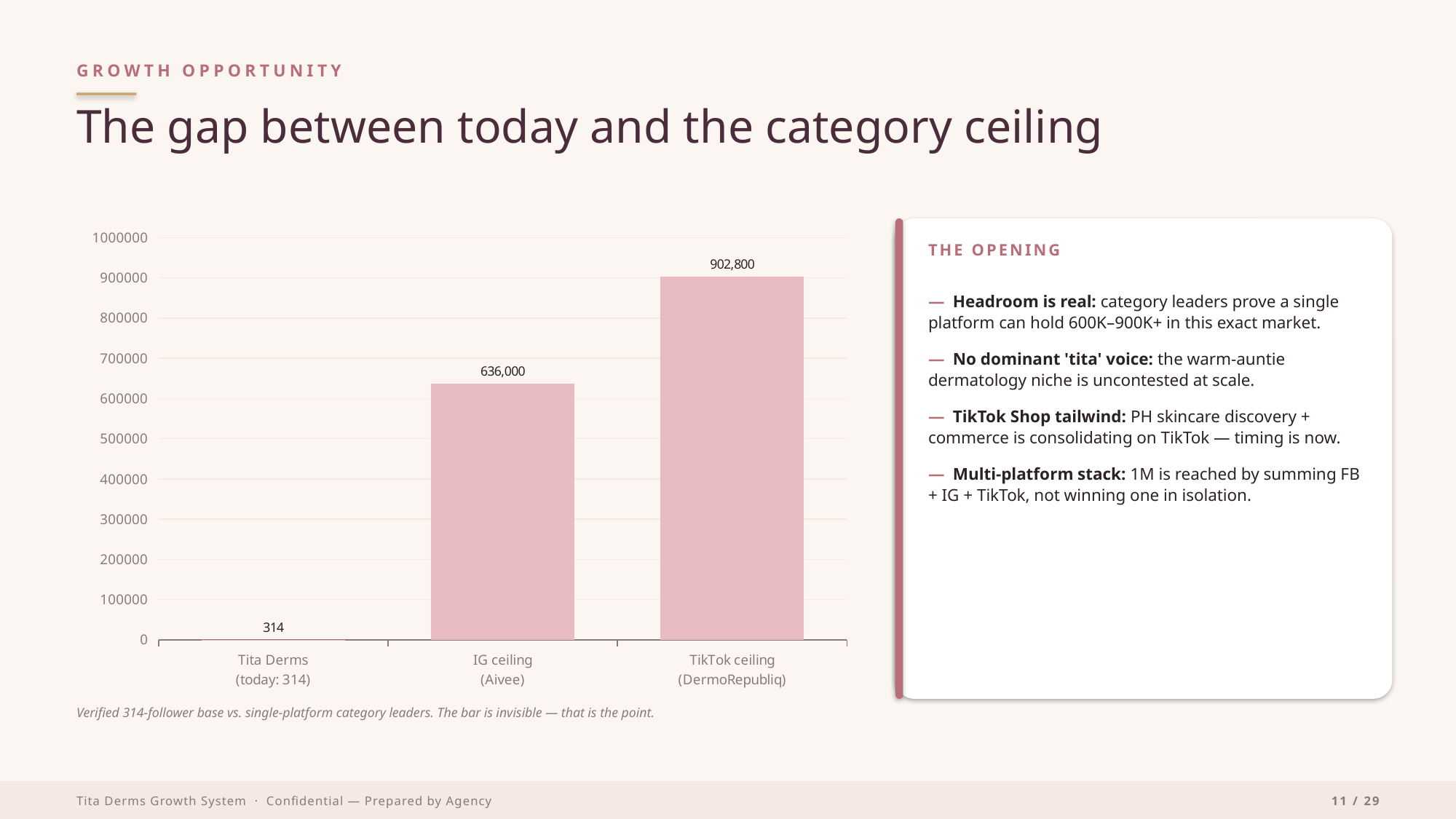
Which category has the lowest value? Tita Derms (today: 314) What is the value for TikTok ceiling (DermoRepubliq)? 902,800 How many categories are shown on the x axis? 3 What is the value for Tita Derms (today)? 314 Is the value for IG ceiling (Aivee) greater or less than 600000? greater What kind of chart is shown on the slide? Bar chart Is the value for TikTok ceiling (DermoRepubliq) greater or less than 1000000? less What is the difference between the TikTok ceiling and the IG ceiling values? 266,800 Do the values rise or fall from left to right along the x axis? Rise Which category has the highest value? TikTok ceiling (DermoRepubliq) Which is larger, the IG ceiling or the TikTok ceiling? TikTok ceiling What is the value for IG ceiling (Aivee)? 636,000